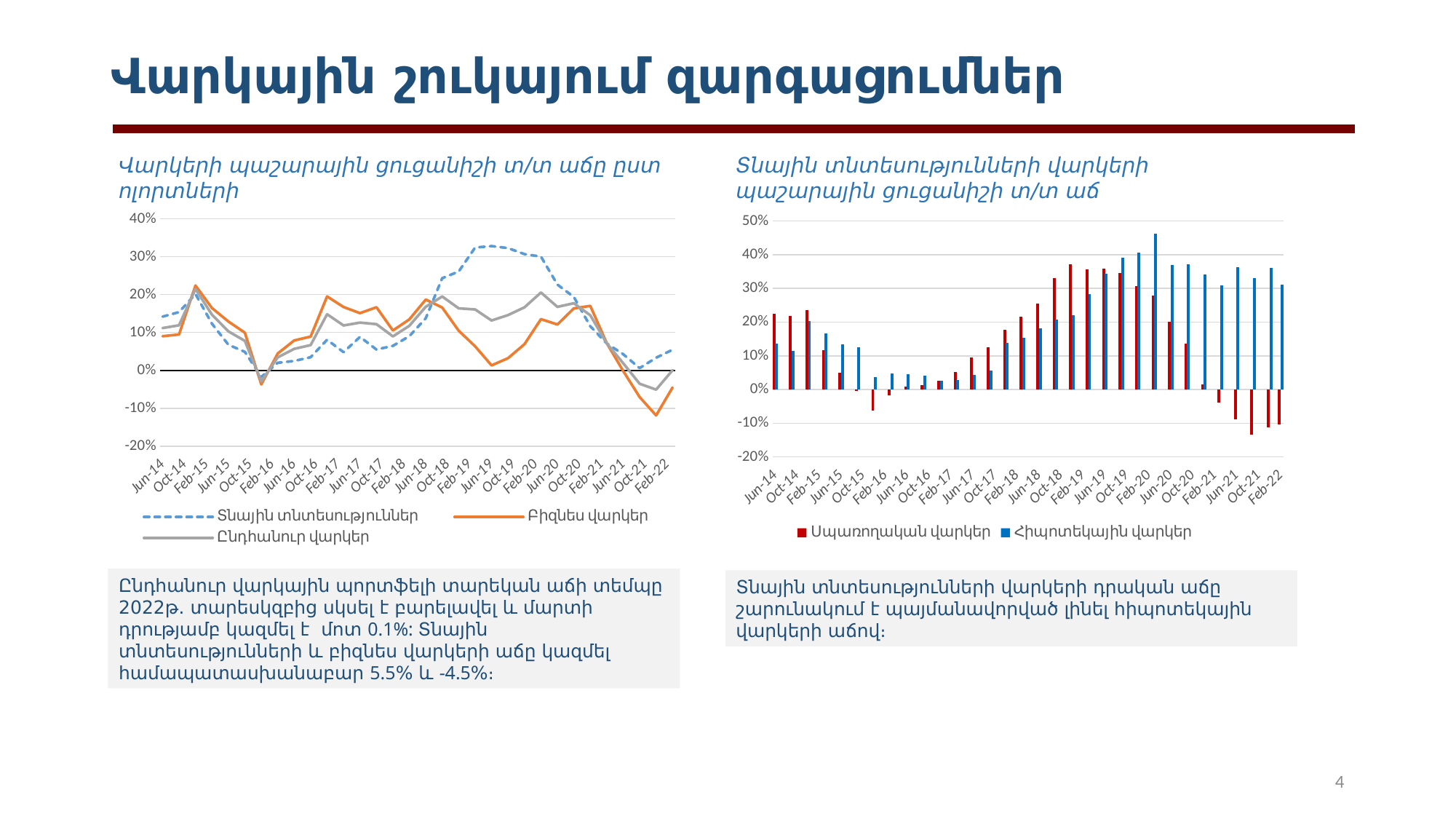
In the right chart, is the value for Սպառողական վարկեր at Oct-21 greater or less than -10%? less In the right chart, do the values for Սպառողական վարկեր rise or fall from Feb-19 to Feb-22? fall How many series does the legend of the left chart list? 3 In the left chart, at Jun-19, which series has the larger value: Տնային տնտեսություններ or Բիզնես վարկեր? Տնային տնտեսություններ In the right chart, at Feb-22, which series has the larger value: Սպառողական վարկեր or Հիպոտեկային վարկեր? Հիպոտեկային վարկեր How many series does the legend of the right chart list? 2 In the left chart, which series is drawn with a dashed line? Տնային տնտեսություններ In the left chart, is the value for Տնային տնտեսություններ at Jun-19 greater or less than 30%? greater In the right chart, is the value for Հիպոտեկային վարկեր at Feb-20 greater or less than 40%? greater What kind of chart is the right chart, 'Տնային տնտեսությունների վարկերի պաշարային ցուցանիշի տ/տ աճ'? Bar chart What kind of chart is the left chart, 'Վարկերի պաշարային ցուցանիշի տ/տ աճը ըստ ոլորտների'? Line chart